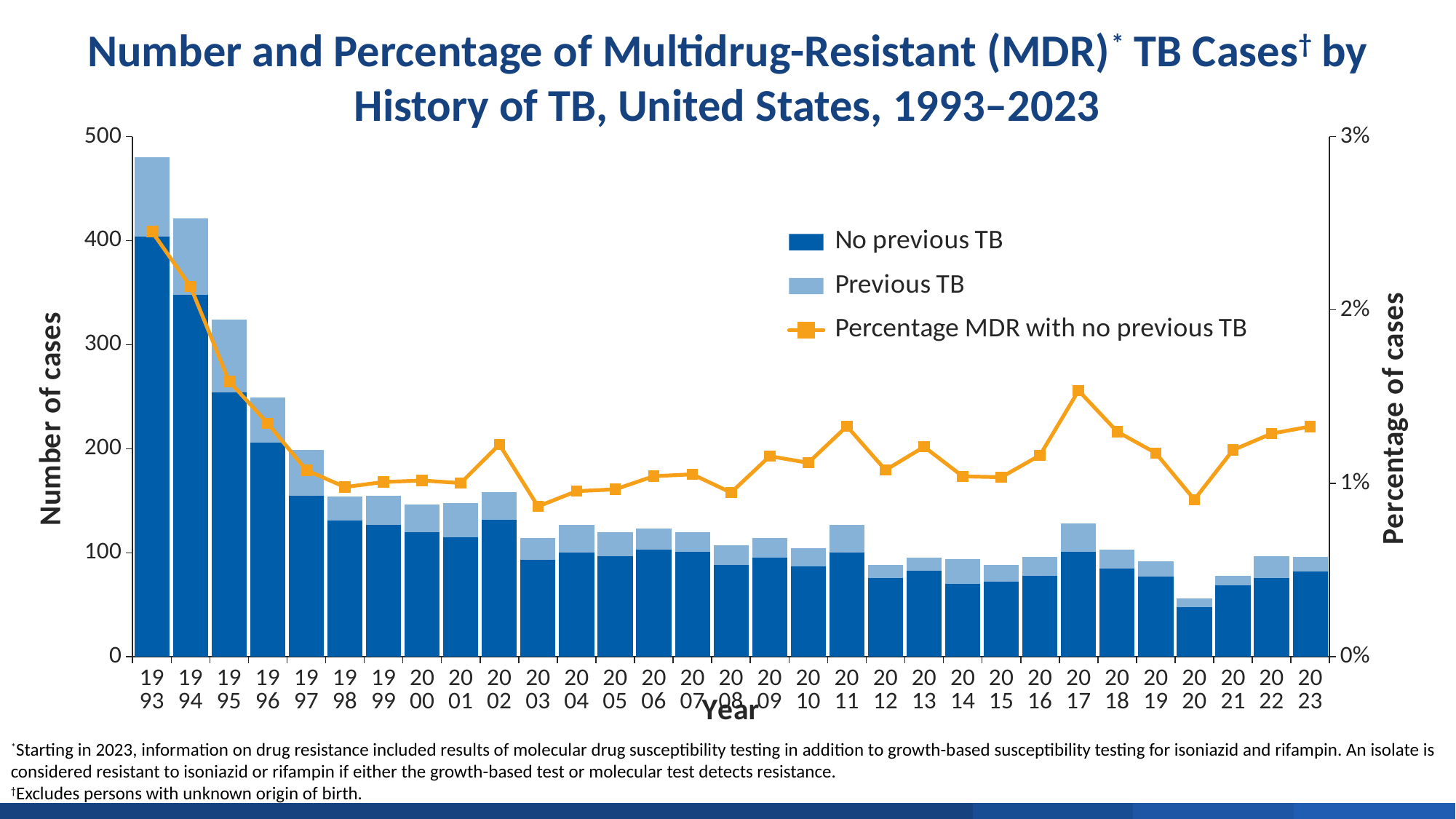
Which series is plotted as an orange line with square markers? Percentage MDR with no previous TB Is the total number of cases in 1993 greater or less than 400? greater What kind of chart is shown on the slide? Combined bar and line chart How many series does the legend list? 3 Which year has the highest total number of MDR TB cases? 1993 Is the total number of cases in 2020 greater or less than 100? less How many years are shown along the x axis? 31 Which year has the lowest total number of MDR TB cases? 2020 Is the percentage MDR with no previous TB in 1993 greater or less than 2%? greater Which year has the larger total number of cases, 2017 or 2020? 2017 Do the total number of cases rise or fall from 1993 to 1998? fall